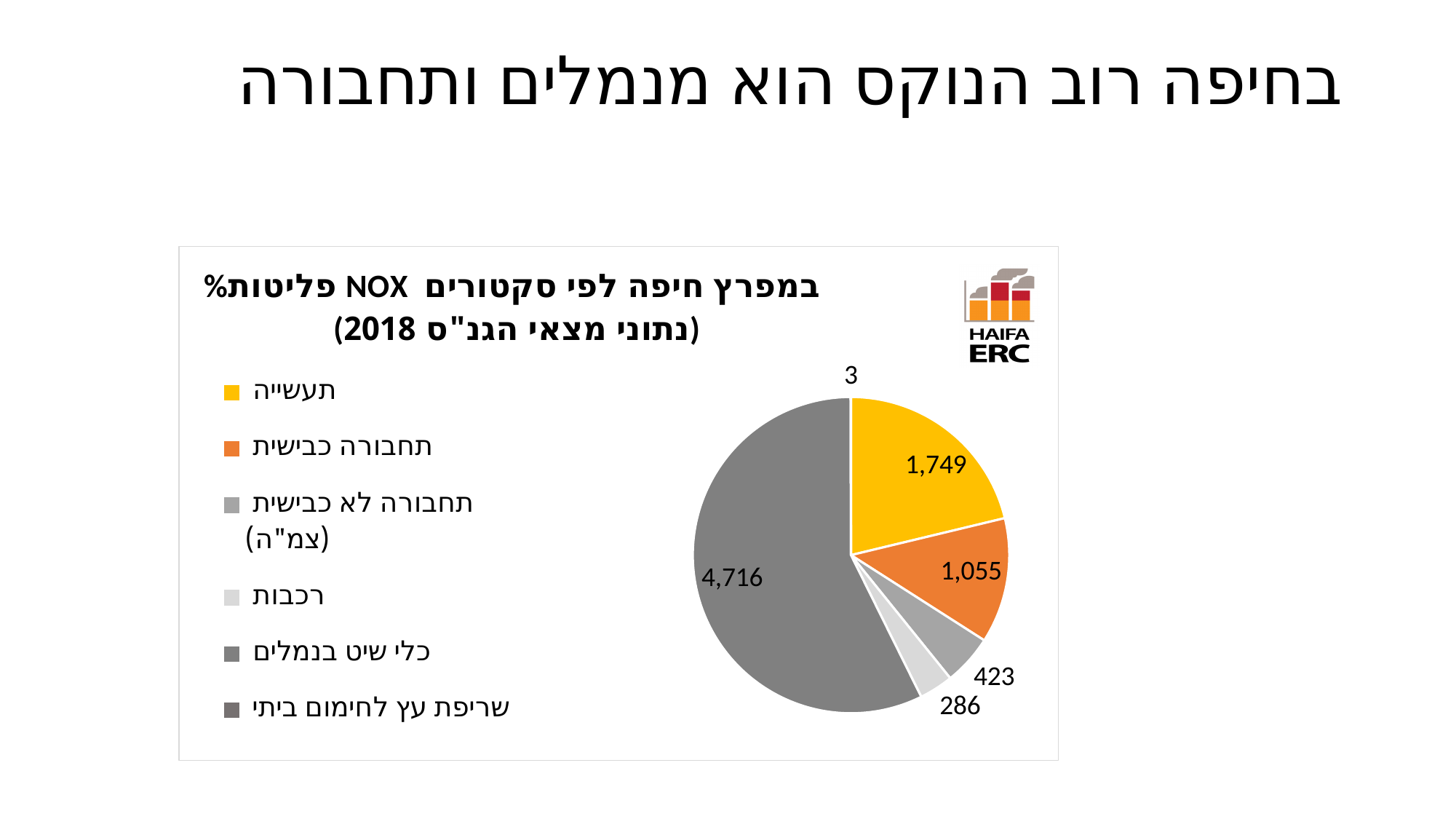
Which is larger: the value for תחבורה לא כבישית (צמ"ה) or the value for רכבות? תחבורה לא כבישית (צמ"ה) How many categories does the legend of the pie chart list? 6 What colour is the slice for תעשייה in the pie chart? Yellow What is the value for תחבורה כבישית in the pie chart? 1,055 What kind of chart is shown on the slide? Pie chart What is the value for רכבות in the pie chart? 286 Which category has the smallest slice in the pie chart? שריפת עץ לחימום ביתי What is the value for תעשייה in the pie chart? 1,749 What is the value for שריפת עץ לחימום ביתי in the pie chart? 3 What is the difference between the values for תעשייה and תחבורה כבישית? 694 Which category has the largest slice in the pie chart? כלי שיט בנמלים What is the value for כלי שיט בנמלים in the pie chart? 4,716